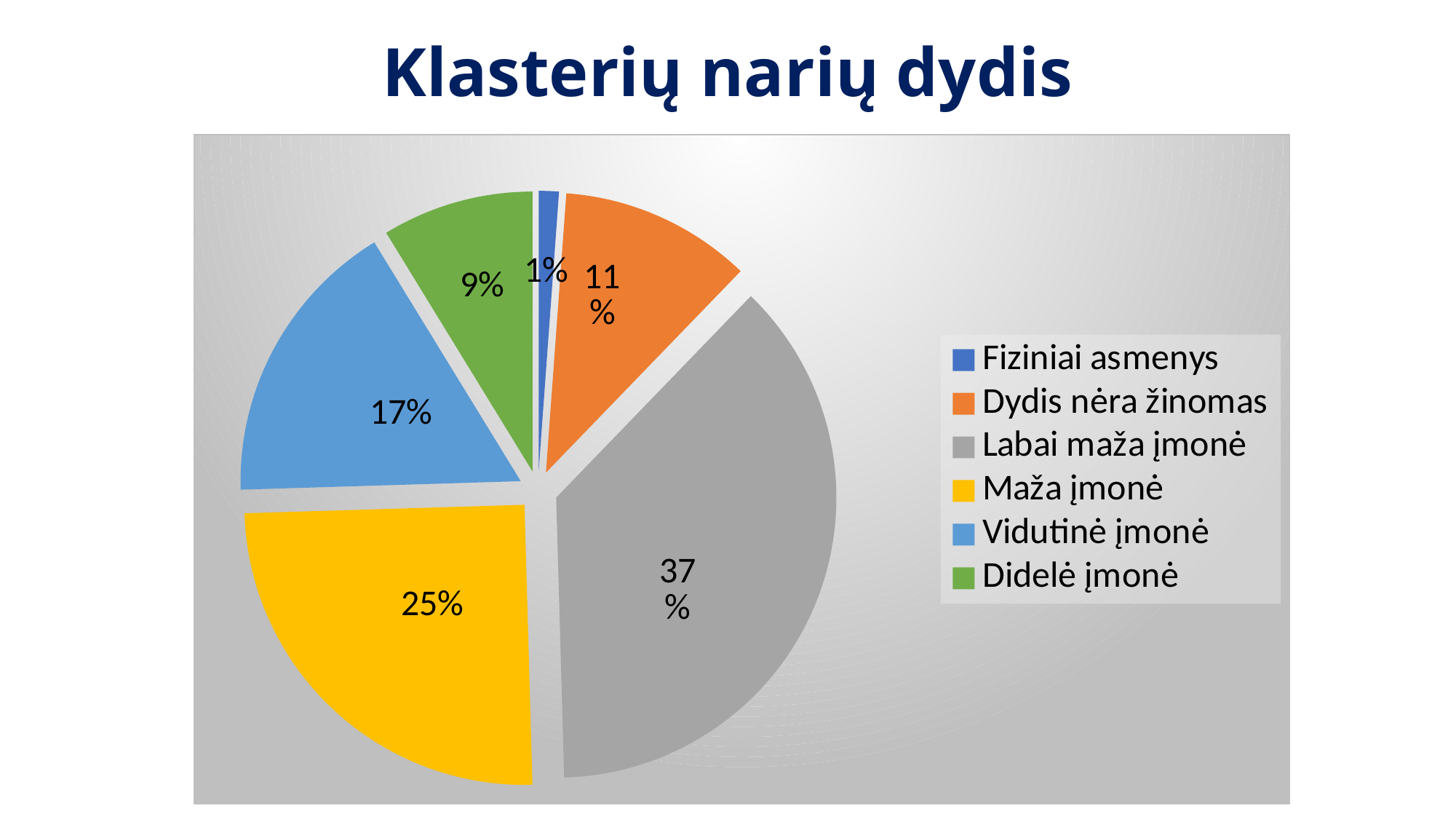
Which is larger, Vidutinė įmonė or Didelė įmonė? Vidutinė įmonė What share of the pie is Fiziniai asmenys? 1% What share of the pie is Vidutinė įmonė? 17% What share of the pie is Dydis nėra žinomas? 11% What is the title of the chart? Klasterių narių dydis Which category has the largest slice? Labai maža įmonė How many categories does the legend list? 6 Which category has the smallest slice? Fiziniai asmenys What kind of chart is shown on the slide? pie chart What is the difference in percentage points between Labai maža įmonė and Maža įmonė? 12